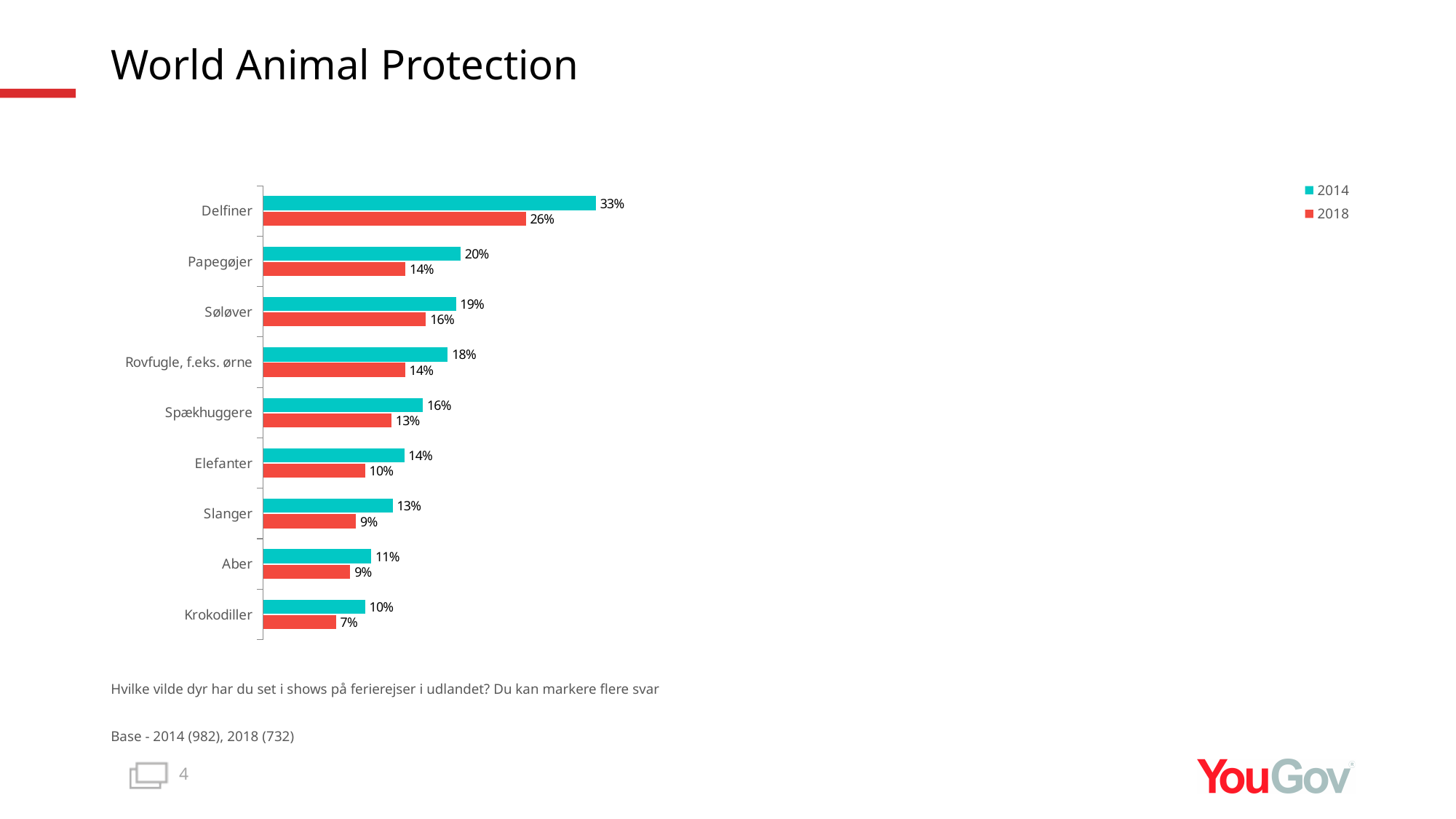
How many animal categories are shown in the chart? 9 Which category has the lowest 2014 value? Krokodiller What is the 2014 value for Delfiner? 33% What is the 2018 value for Krokodiller? 7% Which is larger: the 2018 value for Søløver or the 2018 value for Papegøjer? Søløver What is the difference between the 2014 and 2018 values for Papegøjer? 6% What is the 2018 value for Søløver? 16% What kind of chart is shown on the slide? Bar chart Which colour represents the 2018 series in the chart? Red How many series does the legend list? 2 Which category has the highest 2018 value? Delfiner What is the difference between the 2014 and 2018 values for Delfiner? 7%